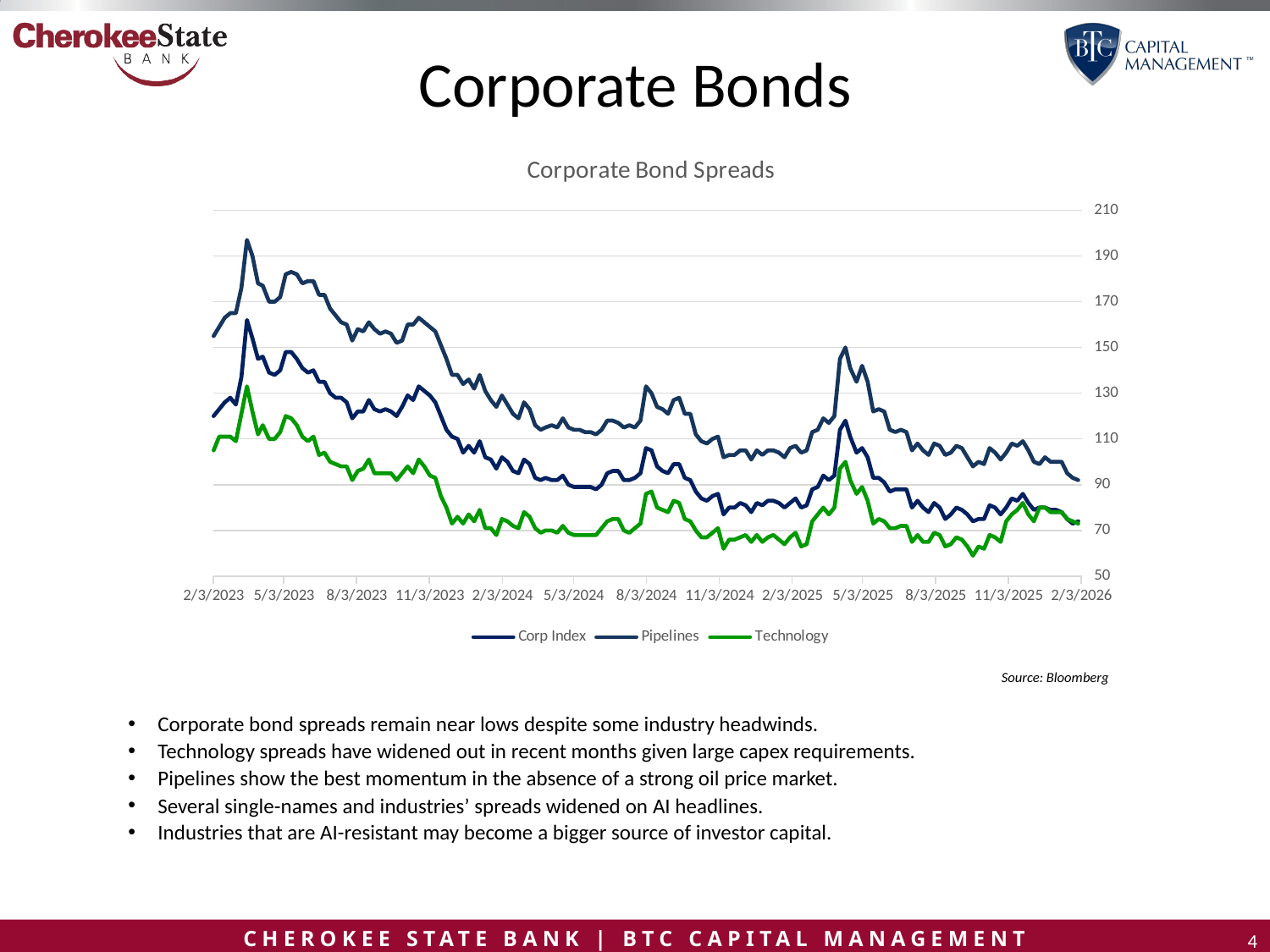
How many date labels are shown on the x axis? 13 Is the value for Technology at 2/3/2026 greater or less than 90? less Do the spread values generally rise or fall from 2/3/2023 to 2/3/2026? fall Which series is plotted in green? Technology Is the highest value reached by any series on the chart greater or less than 190? greater What kind of chart is shown on the slide? Line chart Which series has the lowest values across most of the chart? Technology What is the title of the chart? Corporate Bond Spreads Is the peak value reached by Technology in early 2023 greater or less than 110? greater What is the highest value shown on the y axis? 210 How many series does the chart's legend list? 3